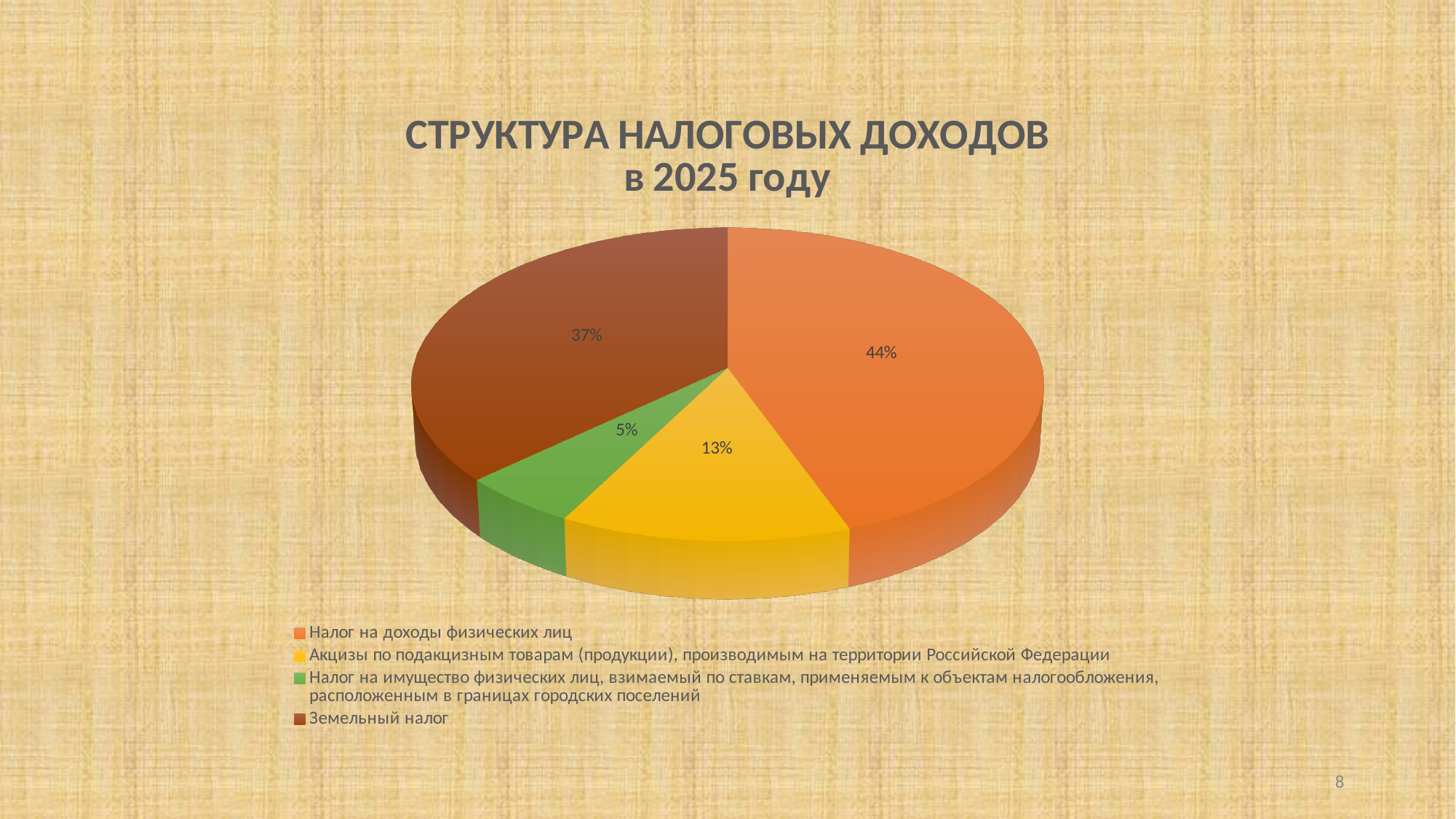
Which category has the smallest share of the pie? Налог на имущество физических лиц Which category has the largest share of the pie? Налог на доходы физических лиц What share of the pie does Земельный налог have? 37% What is the difference in percentage points between Налог на доходы физических лиц and Земельный налог? 7 How many slices does the pie chart have? 4 What share of the pie does Налог на доходы физических лиц have? 44% Which is larger: the share for Акцизы по подакцизным товарам or the share for Налог на имущество физических лиц? Акцизы по подакцизным товарам What is the title of the chart? СТРУКТУРА НАЛОГОВЫХ ДОХОДОВ в 2025 году What share of the pie does Налог на имущество физических лиц have? 5% What colour is the slice for Земельный налог? Brown What kind of chart is shown on the slide? Pie chart